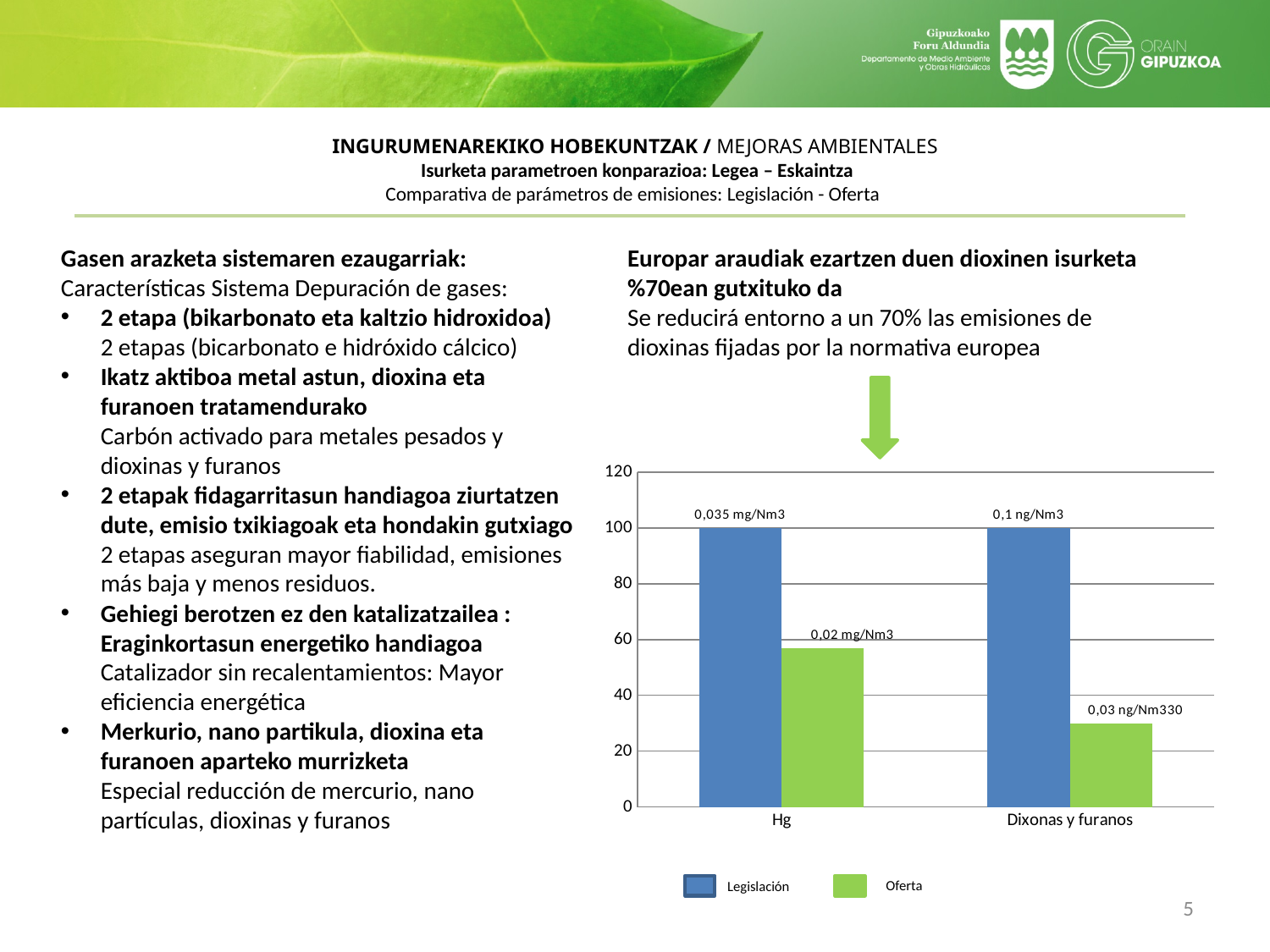
Is the Oferta bar for Dixonas y furanos greater or less than 40 on the y axis? less For Hg, which bar is taller, Legislación or Oferta? Legislación What value on the y axis does the Legislación bar for Hg reach? 100 What kind of chart is shown on the slide? bar chart What data label is printed on the Legislación bar for Dixonas y furanos? 0,1 ng/Nm3 What data label is printed on the Oferta bar for Hg? 0,02 mg/Nm3 How many categories are shown on the x axis of the chart? 2 Which bar is the lowest in the chart? Oferta for Dixonas y furanos Which colour represents the Legislación series in the chart? blue What data label is printed on the Legislación bar for Hg? 0,035 mg/Nm3 Is the Oferta bar for Hg greater or less than 80 on the y axis? less How many series does the chart legend list? 2